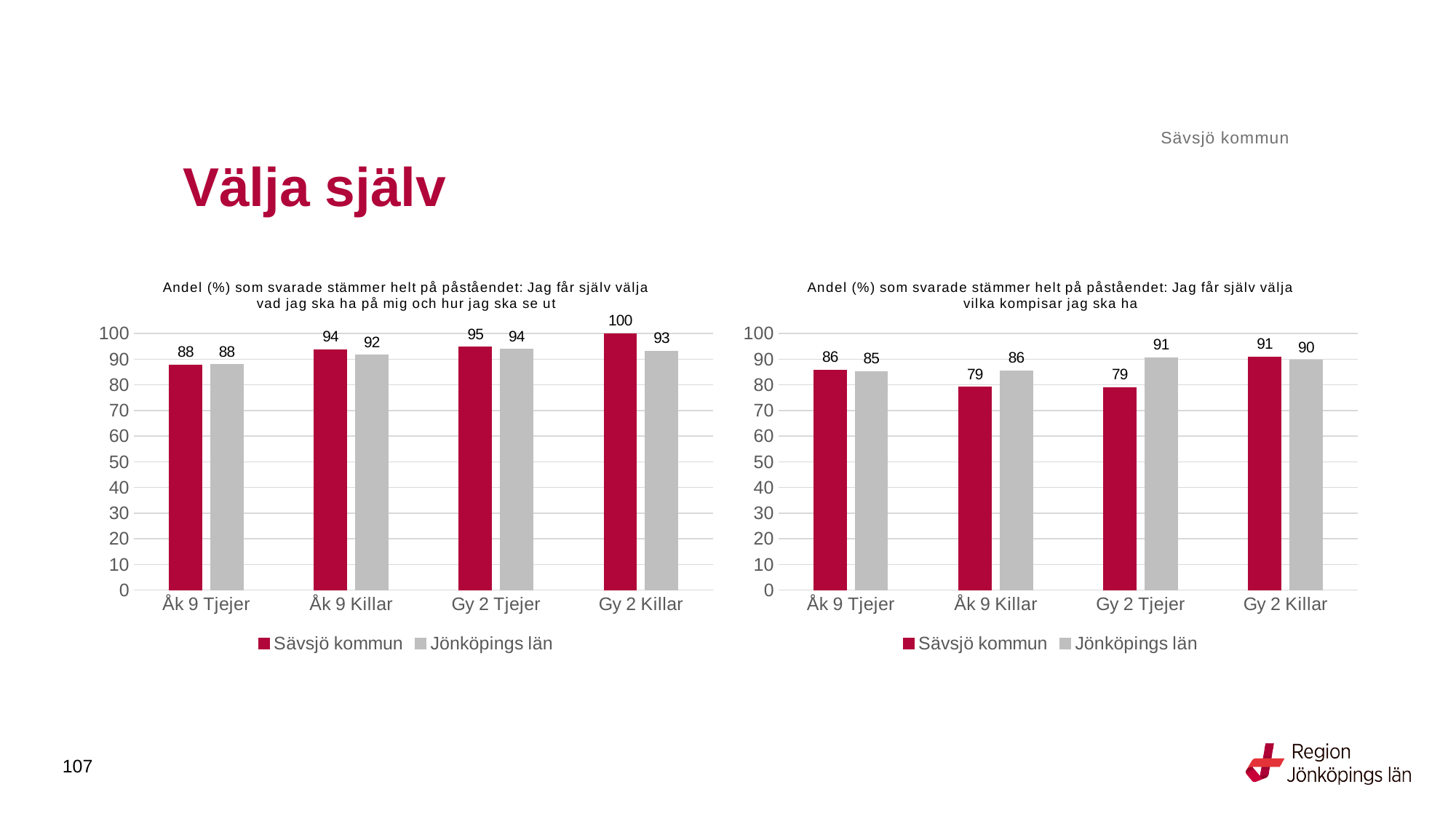
In the right chart (about choosing which friends to have), which category has the lowest Jönköpings län value? Åk 9 Tjejer In the left chart (about choosing what to wear and how to look), which category has the highest Sävsjö kommun value? Gy 2 Killar In the right chart (about choosing which friends to have), what is the value for Sävsjö kommun for Åk 9 Killar? 79 In the right chart (about choosing which friends to have), what is the difference between the Jönköpings län and Sävsjö kommun values for Gy 2 Tjejer? 12 In the left chart (about choosing what to wear and how to look), what is the value for Sävsjö kommun for Gy 2 Killar? 100 In the left chart (about choosing what to wear and how to look), what is the difference between the Sävsjö kommun and Jönköpings län values for Gy 2 Killar? 7 In the right chart (about choosing which friends to have), what is the value for Jönköpings län for Gy 2 Tjejer? 91 How many categories are shown on the x axis of the left chart? 4 How many series does the legend of the right chart list? 2 In the left chart (about choosing what to wear and how to look), what is the value for Jönköpings län for Åk 9 Killar? 92 What kind of chart is the left chart? Bar chart In the right chart (about choosing which friends to have), which is larger for Åk 9 Killar: Sävsjö kommun or Jönköpings län? Jönköpings län